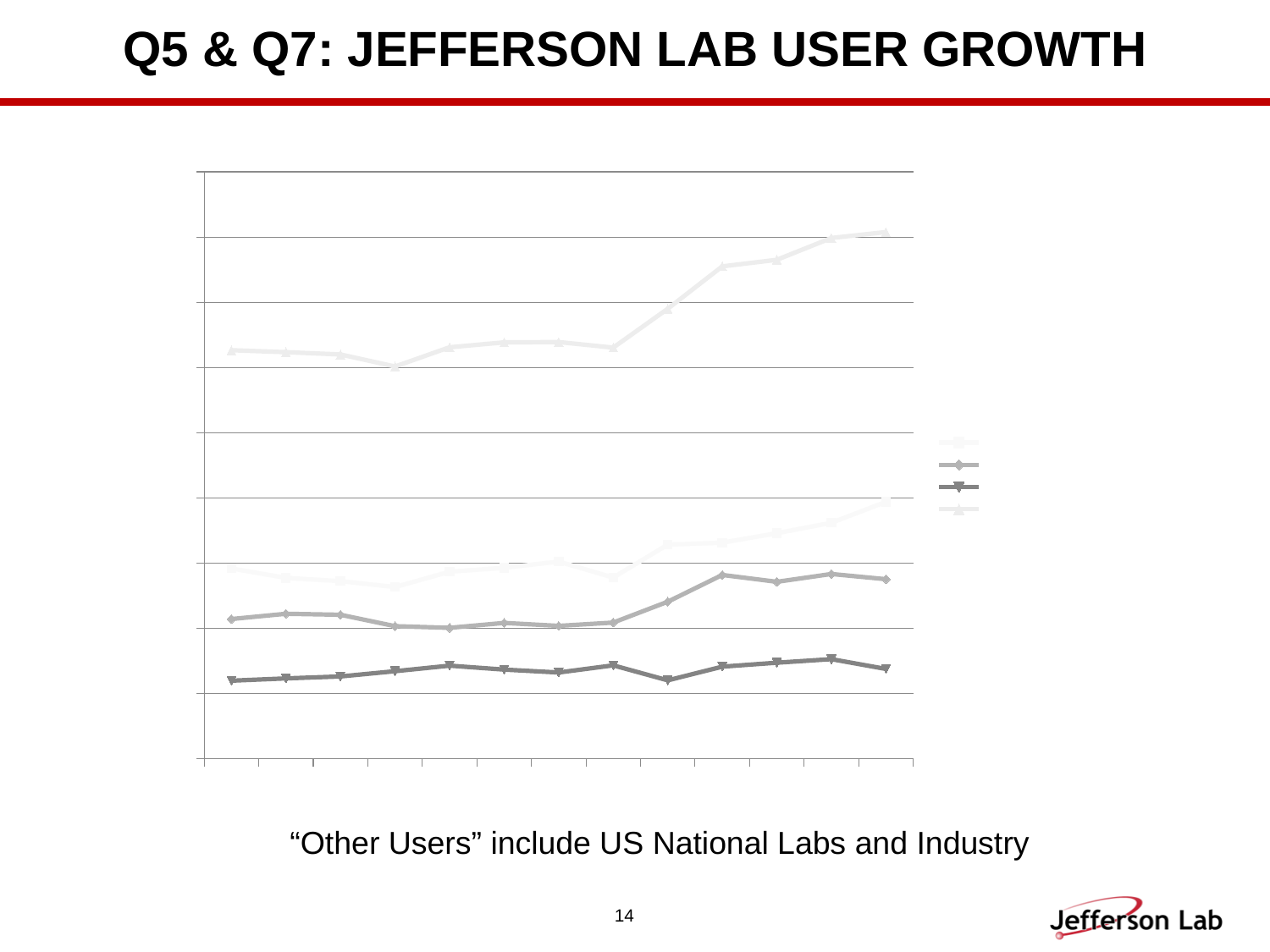
Does the topmost line rise or fall overall from left to right? rise What kind of chart is shown on the slide? line chart What is the title of the slide containing the chart? Q5 & Q7: JEFFERSON LAB USER GROWTH According to the note below the chart, what do "Other Users" include? US National Labs and Industry How many series does the legend list? 4 How many data points does each line have? 13